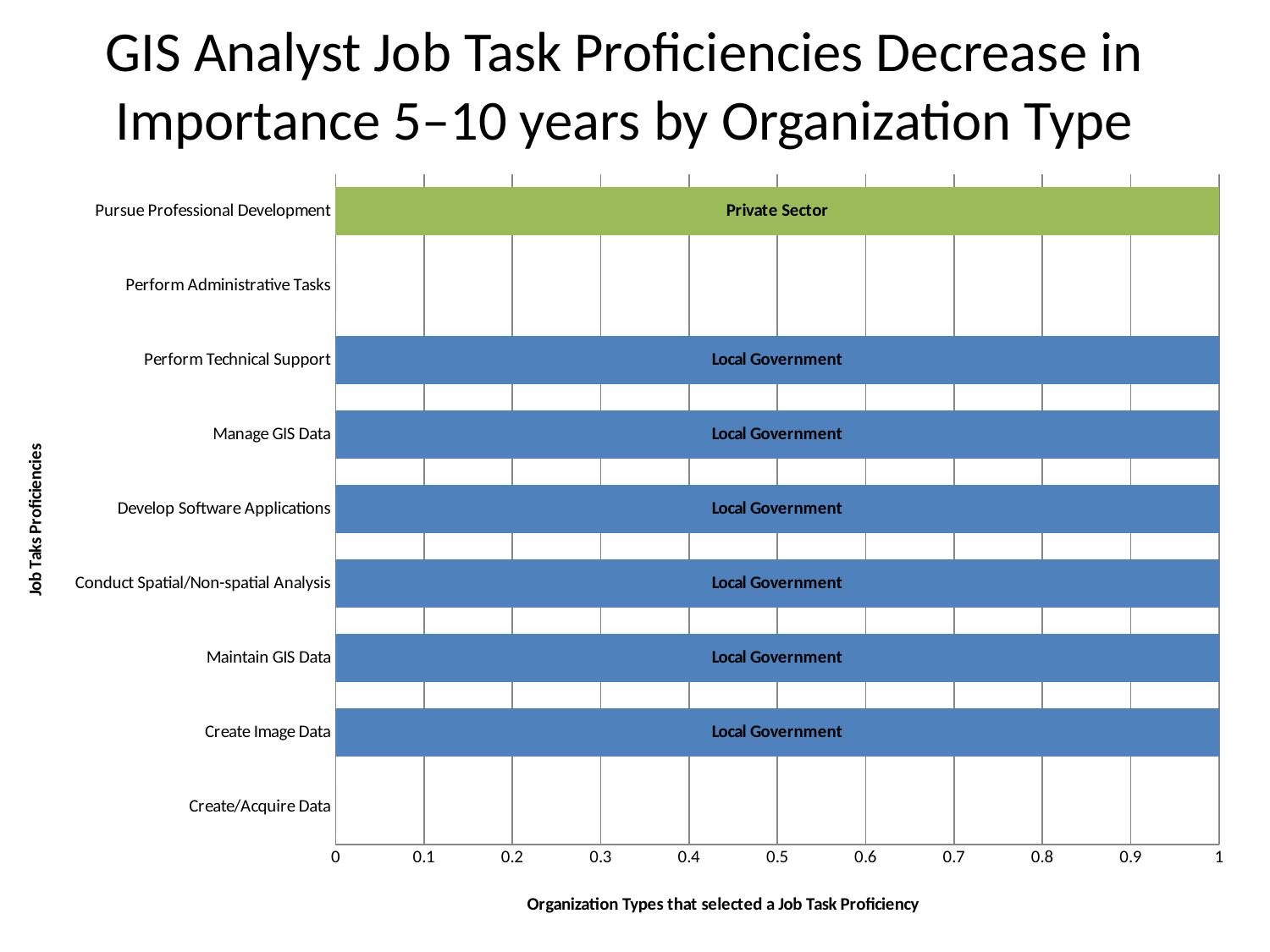
Is the value for Create Image Data greater or less than 0.9? greater How many categories have a bar labelled Local Government? 6 Which organization type is labelled on the bar for Perform Technical Support? Local Government Which two categories have no bar plotted? Perform Administrative Tasks and Create/Acquire Data Is the value for Maintain GIS Data greater or less than 0.5? greater What kind of chart is shown on the slide? Bar chart What value does the bar for Pursue Professional Development reach on the x axis? 1 What is the highest value shown on the x axis? 1 Which organization type is labelled on the bar for Pursue Professional Development? Private Sector What value does the bar for Manage GIS Data reach on the x axis? 1 How many job task proficiency categories are listed on the y axis? 9